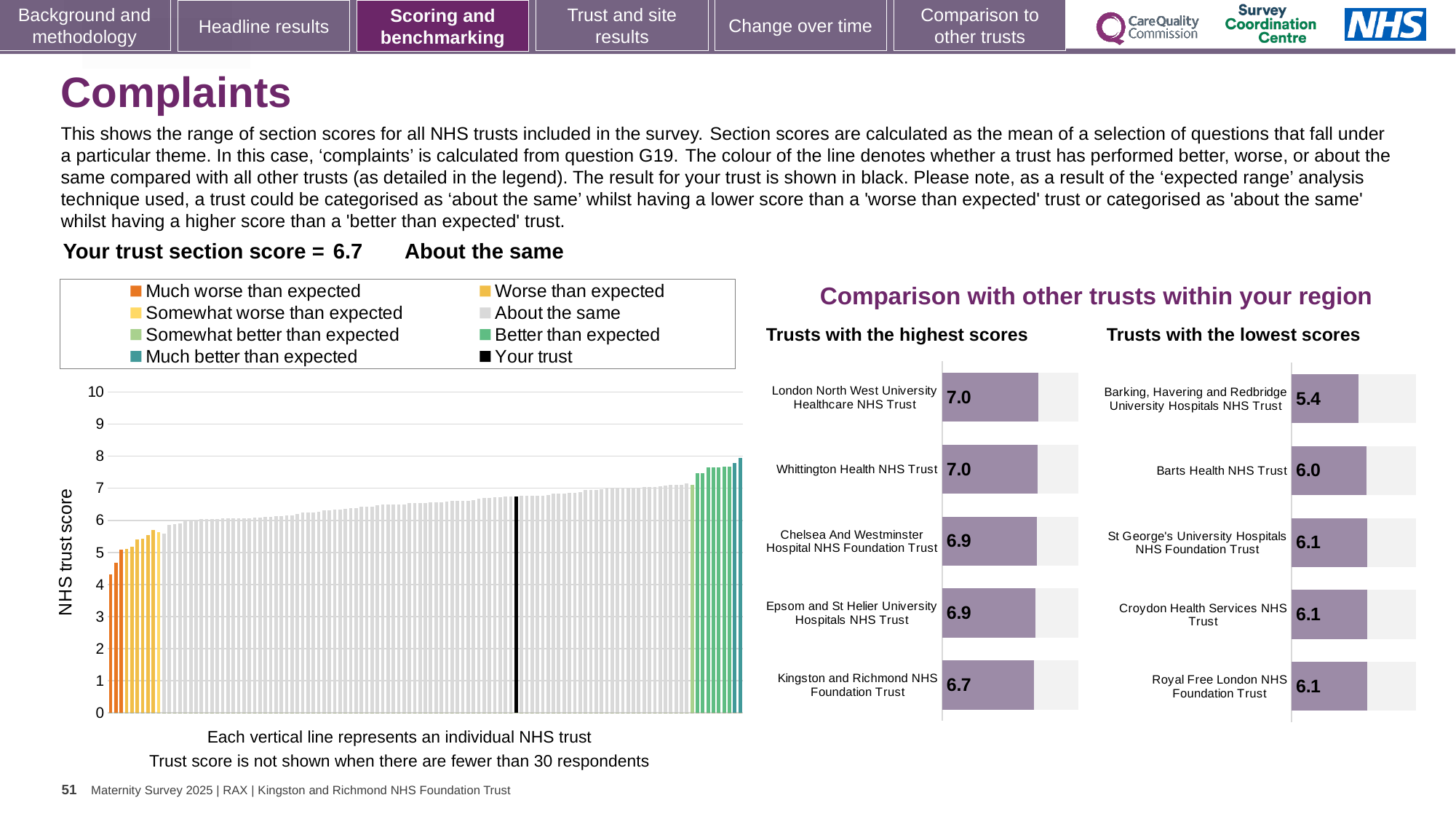
In the large chart on the left showing NHS trust scores, is the value of the lowest bar greater or less than 5? less In the 'Trusts with the highest scores' chart, what is the difference between the score for London North West University Healthcare NHS Trust and the score for Kingston and Richmond NHS Foundation Trust? 0.3 In the 'Trusts with the highest scores' chart, which trust has the lowest score shown? Kingston and Richmond NHS Foundation Trust In the 'Trusts with the lowest scores' chart, what is the difference between the score for Royal Free London NHS Foundation Trust and the score for Barking, Havering and Redbridge University Hospitals NHS Trust? 0.7 In the 'Trusts with the highest scores' chart, what is the score for Whittington Health NHS Trust? 7.0 In the 'Trusts with the highest scores' chart, what is the score for Kingston and Richmond NHS Foundation Trust? 6.7 In the 'Trusts with the lowest scores' chart, which trust has the lowest score? Barking, Havering and Redbridge University Hospitals NHS Trust In the 'Trusts with the lowest scores' chart, which has the larger score: Barts Health NHS Trust or Croydon Health Services NHS Trust? Croydon Health Services NHS Trust In the 'Trusts with the lowest scores' chart, what is the score for Barts Health NHS Trust? 6.0 What kind of chart is the large chart on the left showing NHS trust scores? bar chart How many trusts are listed in the 'Trusts with the highest scores' chart? 5 How many entries does the legend of the large chart on the left list? 8